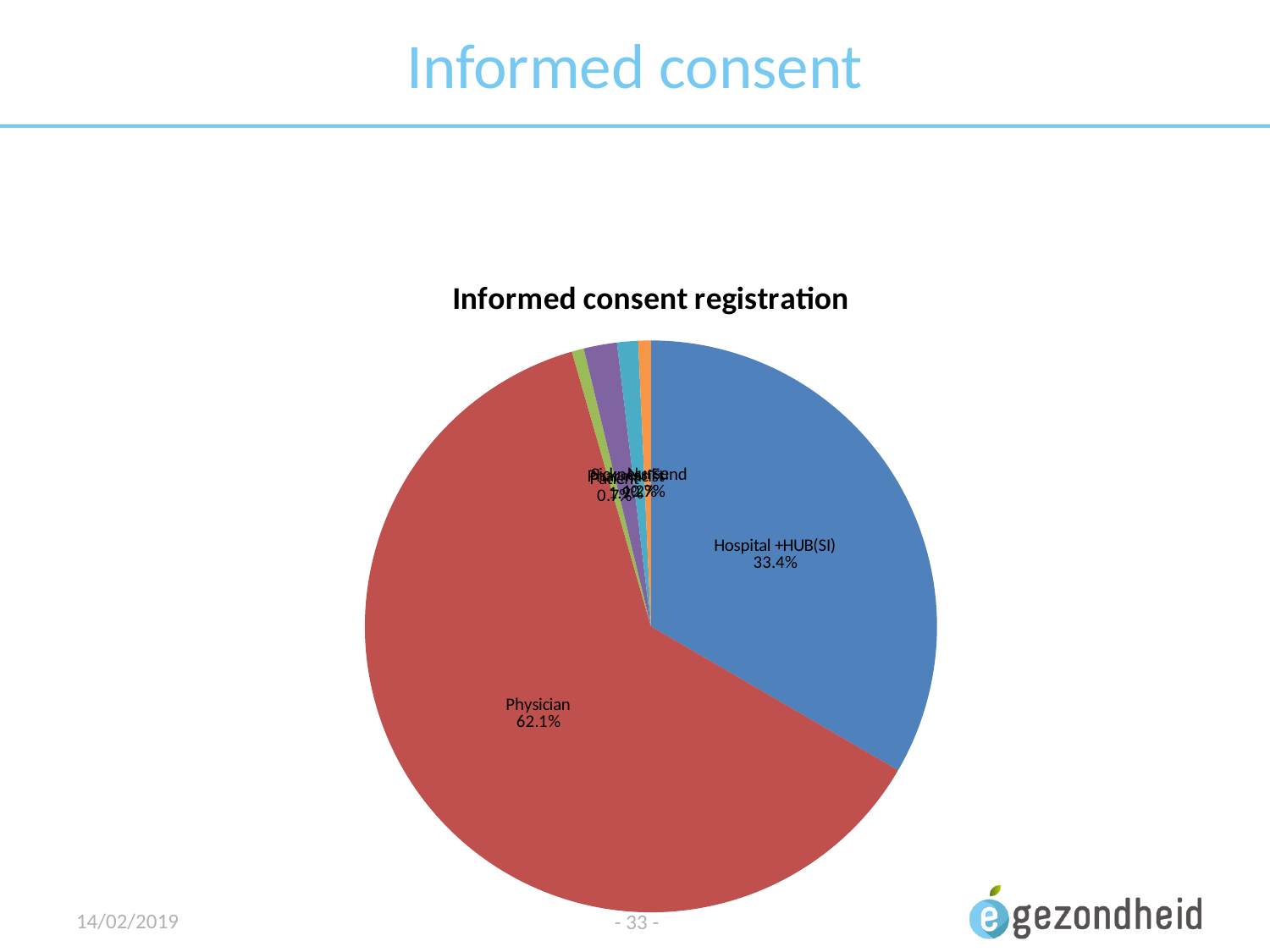
What colour is the Physician slice? Red Which category has the largest slice of the pie? Physician What share of the pie does Physician account for? 62.1% What is the title of the chart? Informed consent registration Does the Physician slice make up more than half of the pie? Yes What kind of chart is shown on the slide? Pie chart What share of the pie does Hospital +HUB(SI) account for? 33.4% What is the difference in percentage points between the Physician slice and the Hospital +HUB(SI) slice? 28.7% How many slices does the pie chart have? 6 Which is larger, the Physician slice or the Hospital +HUB(SI) slice? Physician